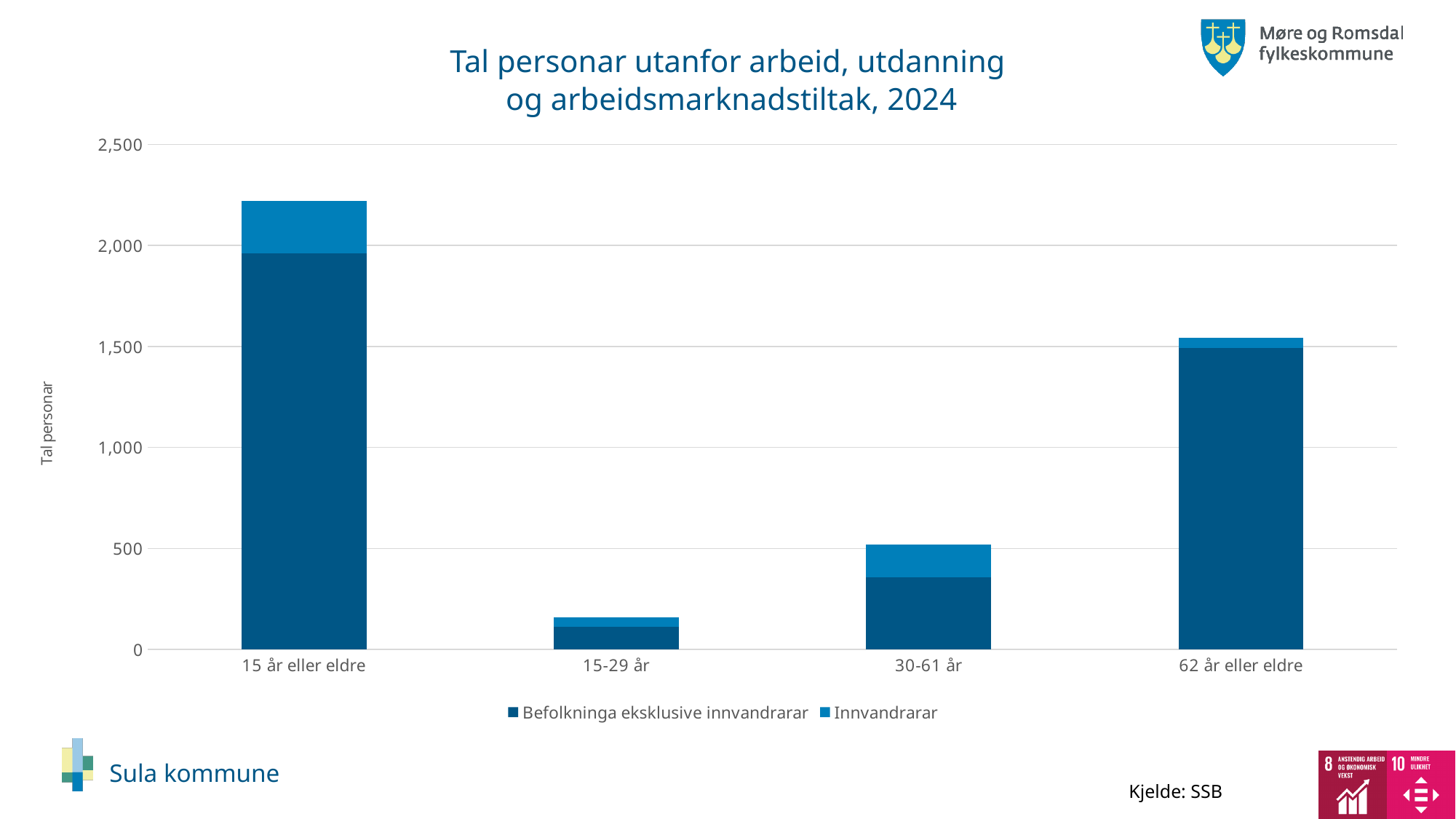
Which age category has the shortest stacked bar? 15-29 år Which age category has the tallest stacked bar? 15 år eller eldre Is the total value for 15-29 år greater or less than 500? less What kind of chart is shown on the slide? Bar chart How many series does the legend list? 2 Is the total value for 30-61 år greater or less than 1,000? less Which stacked bar is taller: 30-61 år or 62 år eller eldre? 62 år eller eldre Is the total value for 15 år eller eldre greater or less than 2,000? greater Which stacked bar is taller: 15-29 år or 30-61 år? 30-61 år How many age categories are shown on the x axis? 4 What is the label on the vertical axis of the chart? Tal personar